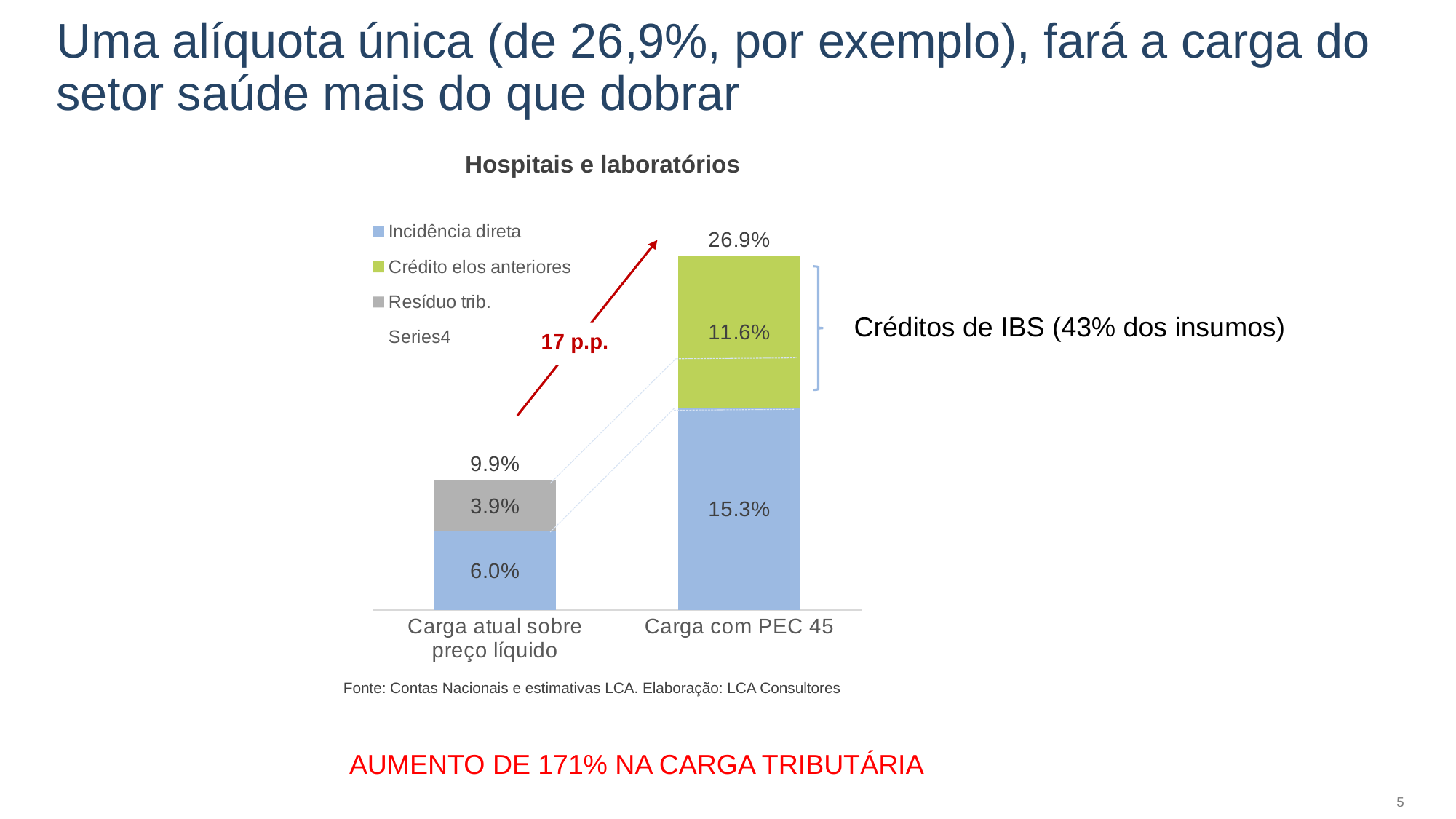
How many categories are shown on the x axis of the chart? 2 What kind of chart is shown on the slide? Stacked bar chart What is the value of Incidência direta for Carga com PEC 45? 15.3% What is the total of the stacked bar for Carga com PEC 45? 26.9% How many entries does the chart's legend list? 4 What is the total of the stacked bar for Carga atual sobre preço líquido? 9.9% What is the difference between the Incidência direta values for Carga com PEC 45 and Carga atual sobre preço líquido? 9.3 percentage points What is the value of Resíduo trib. for Carga atual sobre preço líquido? 3.9% What is the title of the chart? Hospitais e laboratórios Which category has the higher total, Carga atual sobre preço líquido or Carga com PEC 45? Carga com PEC 45 What is the value of Incidência direta for Carga atual sobre preço líquido? 6.0% What is the value of Crédito elos anteriores for Carga com PEC 45? 11.6%